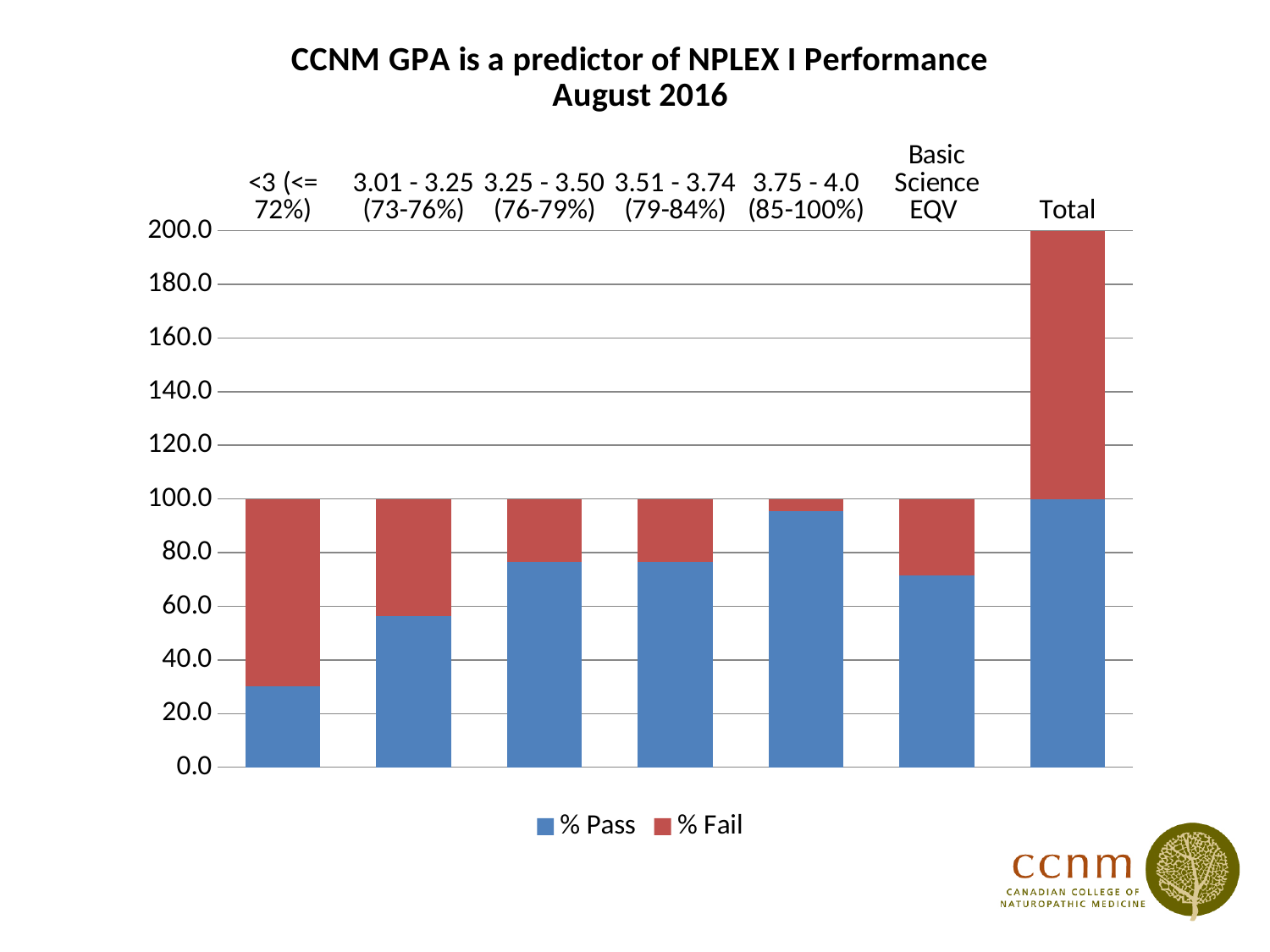
Which colour represents % Fail in the chart? red What kind of chart is shown on the slide? bar chart Does % Pass generally rise or fall moving from <3 (<= 72%) to 3.75 - 4.0 (85-100%)? rise Is the % Pass value for 3.75 - 4.0 (85-100%) greater or less than 80? greater Which has the larger % Pass: 3.01 - 3.25 (73-76%) or Basic Science EQV? Basic Science EQV Among the GPA ranges (excluding Total), which category has the highest % Pass? 3.75 - 4.0 (85-100%) Is the % Pass value for <3 (<= 72%) greater or less than 40? less What is the % Pass value for the Total category? 100.0 Is the % Pass value for Basic Science EQV greater or less than 80? less How many series does the legend list? 2 Which category has the lowest % Pass? <3 (<= 72%) How many categories are plotted along the x axis? 7